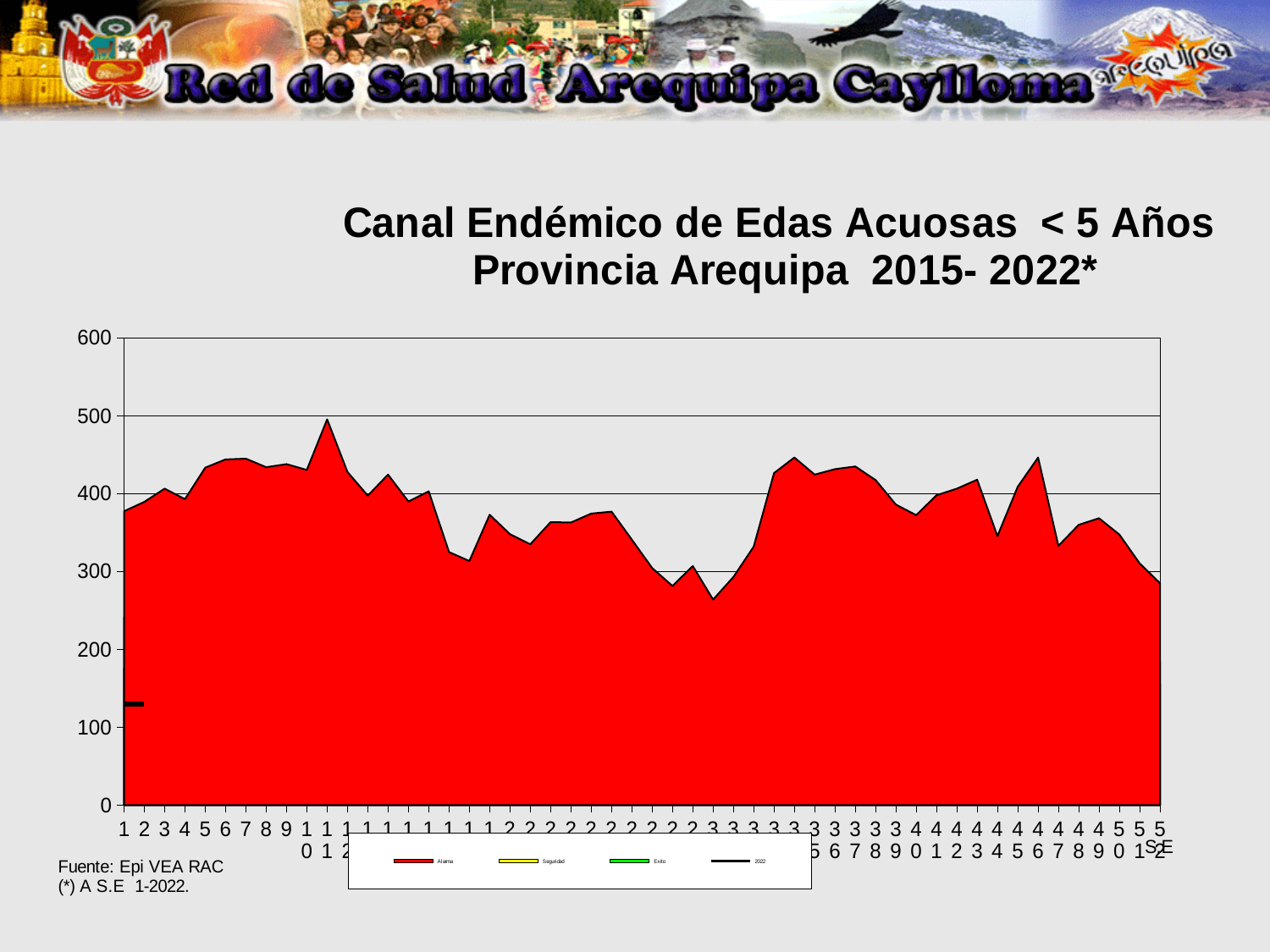
What colour is used for the Alarma series in the chart? Red What is the title of the chart? Canal Endémico de Edas Acuosas < 5 Años Provincia Arequipa 2015- 2022* How many series does the chart legend list? 4 Which is larger, the Alarma value at week 11 or at week 31? Week 11 At which week does the red Alarma area reach its lowest point? Week 30 Is the value of the Alarma area at week 11 greater or less than 400? greater Is the value of the Alarma area at week 1 greater or less than 300? greater What kind of chart is shown on the slide? Area chart How many epidemiological weeks (SE) are shown along the x axis? 52 At which week does the red Alarma area reach its highest point? Week 11 Do the Alarma values rise or fall from week 46 to week 52? Fall